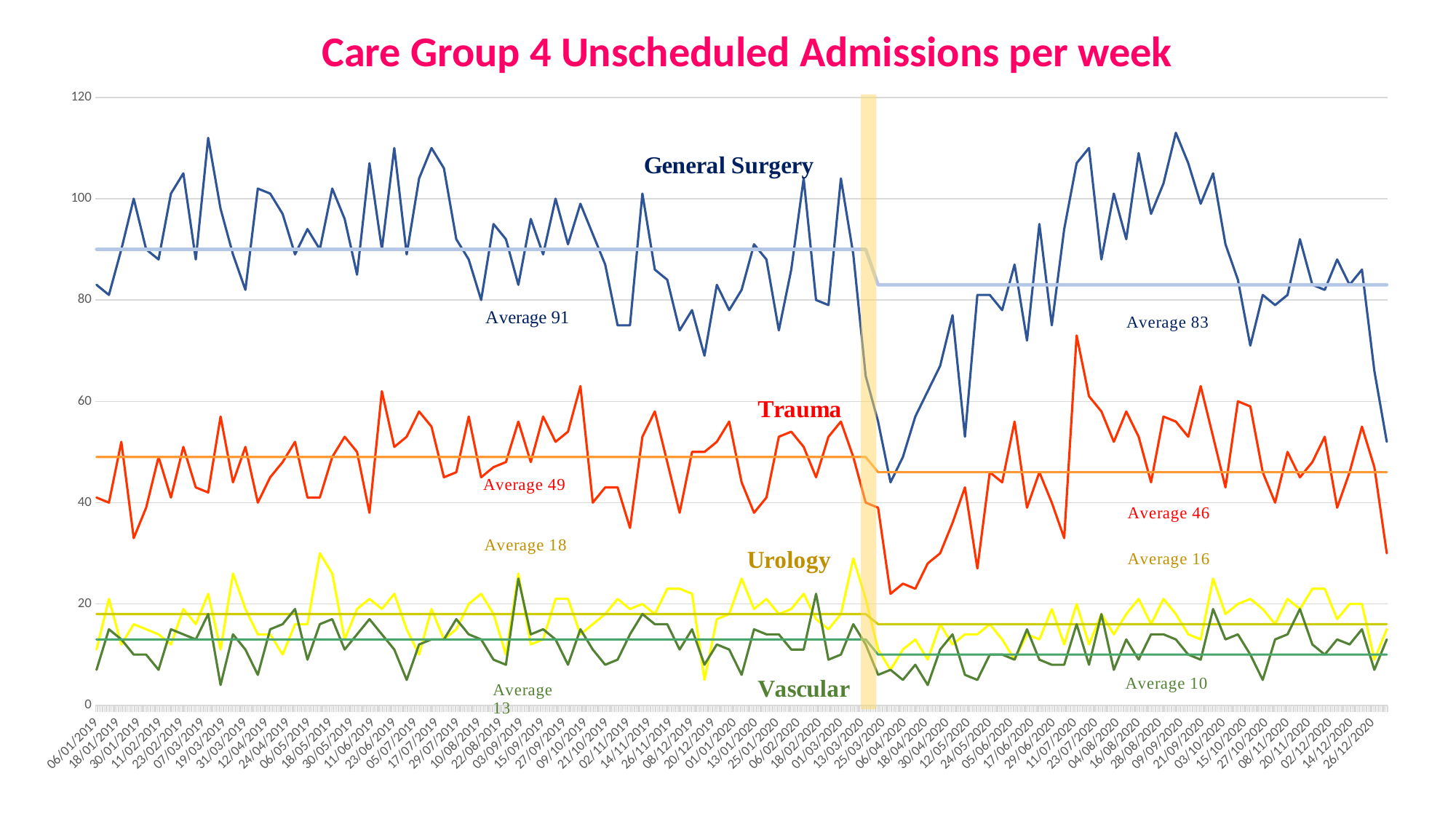
What is the average for Vascular in the period after the highlighted band? Average 10 What is the average for Urology in the period before the highlighted band? Average 18 Which specialty has the lowest average in the later period? Vascular What is the average for Trauma in the period after the highlighted band? Average 46 What is the average for General Surgery in the period after the highlighted band? Average 83 By how much did the General Surgery average fall from the earlier period (91) to the later period (83)? 8 Which specialty has the highest average in the earlier period? General Surgery Did the Trauma average rise or fall between the earlier period and the later period? Fall What is the title of the chart? Care Group 4 Unscheduled Admissions per week What is the average for General Surgery in the period before the highlighted band? Average 91 What kind of chart is shown on the slide? Line chart How many data series (specialties) are plotted on the chart? 4